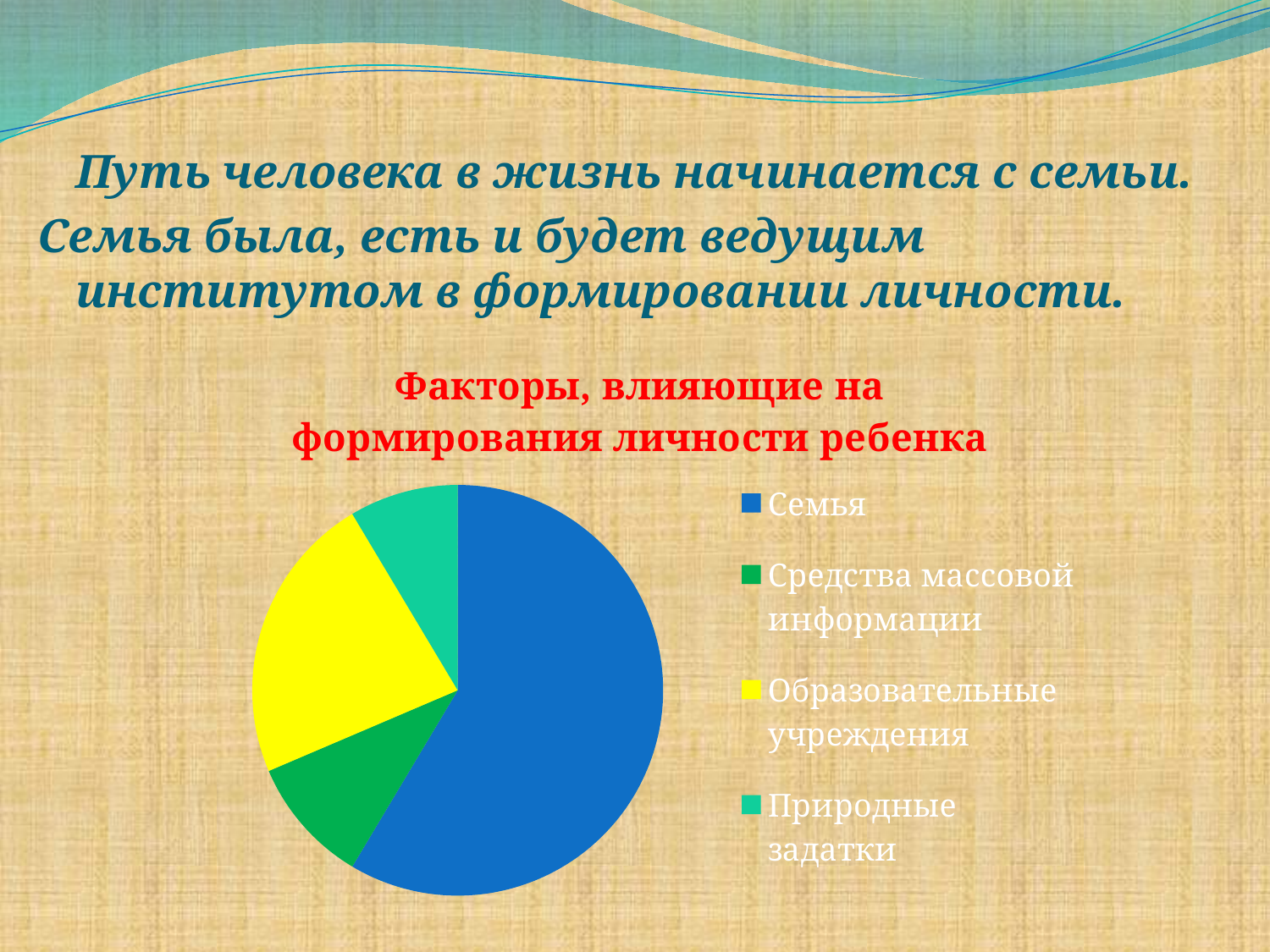
Which slice is larger: Образовательные учреждения or Природные задатки? Образовательные учреждения What is the title of the chart? Факторы, влияющие на формирования личности ребенка Which category has the largest slice of the pie? Семья Which slice is larger: Семья or Средства массовой информации? Семья Which slice is larger: Семья or Образовательные учреждения? Семья How many entries does the legend list? 4 What kind of chart is shown on the slide? Pie chart How many slices does the pie chart have? 4 What colour is the slice for Образовательные учреждения? Yellow